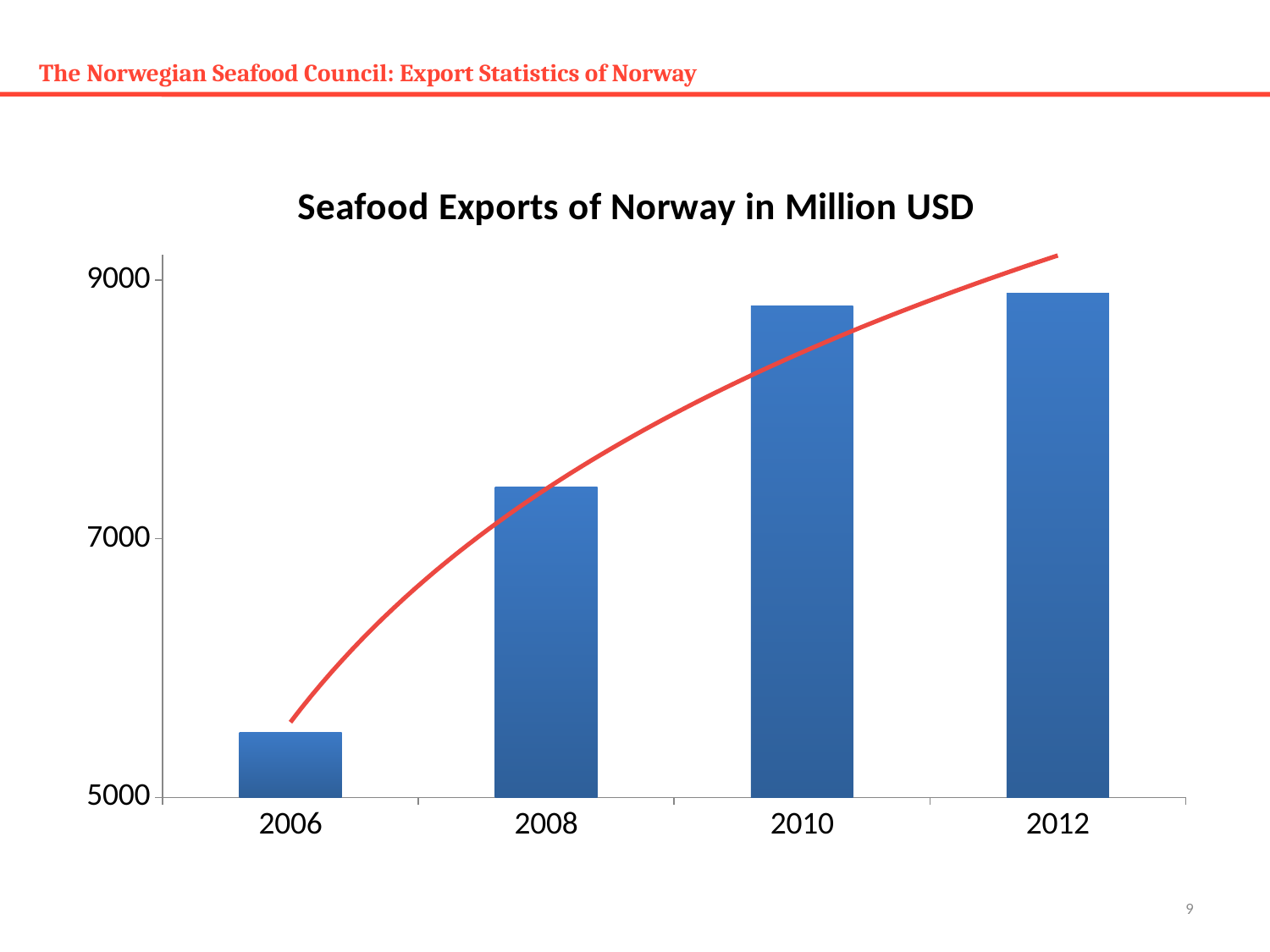
Is the value for 2010 greater or less than 9000? less What colour is the curved trend line drawn over the bars? red What kind of chart is shown on the slide? bar chart Is the value for 2012 greater or less than 9000? less Is the value for 2006 greater or less than 7000? less Do the seafood export values rise or fall from 2006 to 2012? rise Which is larger, the value for 2006 or the value for 2008? 2008 How many years are shown on the x axis of the chart? 4 What is the title of the chart? Seafood Exports of Norway in Million USD Which year has the lowest seafood export value? 2006